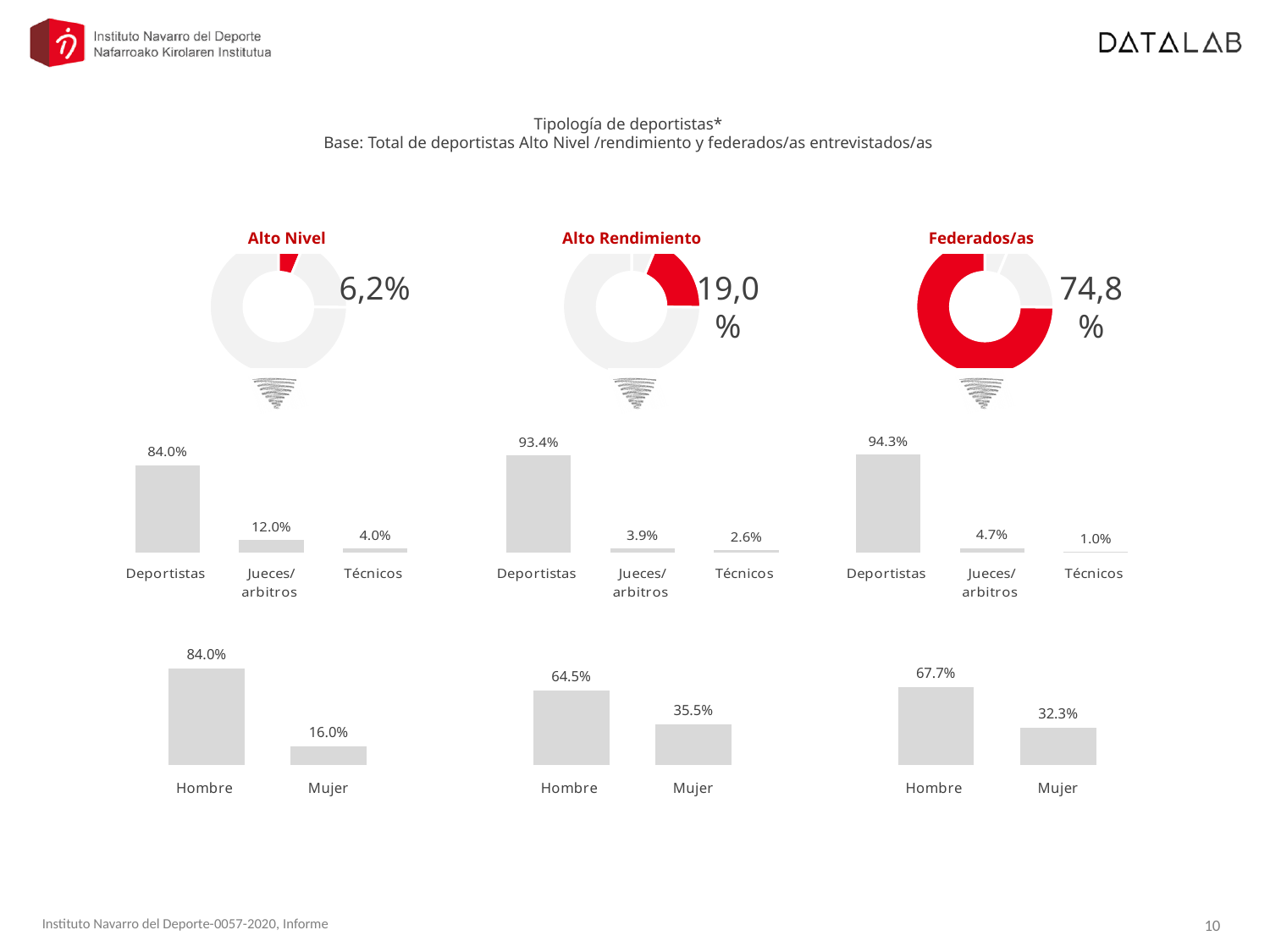
In the Hombre/Mujer bar chart under Alto Rendimiento, what is the value for Mujer? 35.5% Among the three donut charts (Alto Nivel, Alto Rendimiento, Federados/as), which has the highest percentage? Federados/as In the bar chart under Federados/as showing Deportistas, Jueces/arbitros and Técnicos, what is the difference between Deportistas and Jueces/arbitros? 89.6% In the bar chart under Alto Rendimiento showing Deportistas, Jueces/arbitros and Técnicos, what is the value for Jueces/arbitros? 3.9% In the Federados/as donut chart, what percentage is shown? 74,8% In the Alto Nivel donut chart, what percentage is shown? 6,2% How many categories are shown in the bar chart under Alto Rendimiento with Deportistas, Jueces/arbitros and Técnicos? 3 What type of chart is used for the Hombre/Mujer comparison under Alto Nivel? Bar chart In the bar chart under Federados/as showing Deportistas, Jueces/arbitros and Técnicos, which category has the lowest value? Técnicos In the bar chart under Alto Nivel showing Deportistas, Jueces/arbitros and Técnicos, what is the value for Deportistas? 84.0% In the Hombre/Mujer bar chart under Federados/as, what is the difference between Hombre and Mujer? 35.4% In the Hombre/Mujer bar chart under Alto Nivel, which is larger, Hombre or Mujer? Hombre